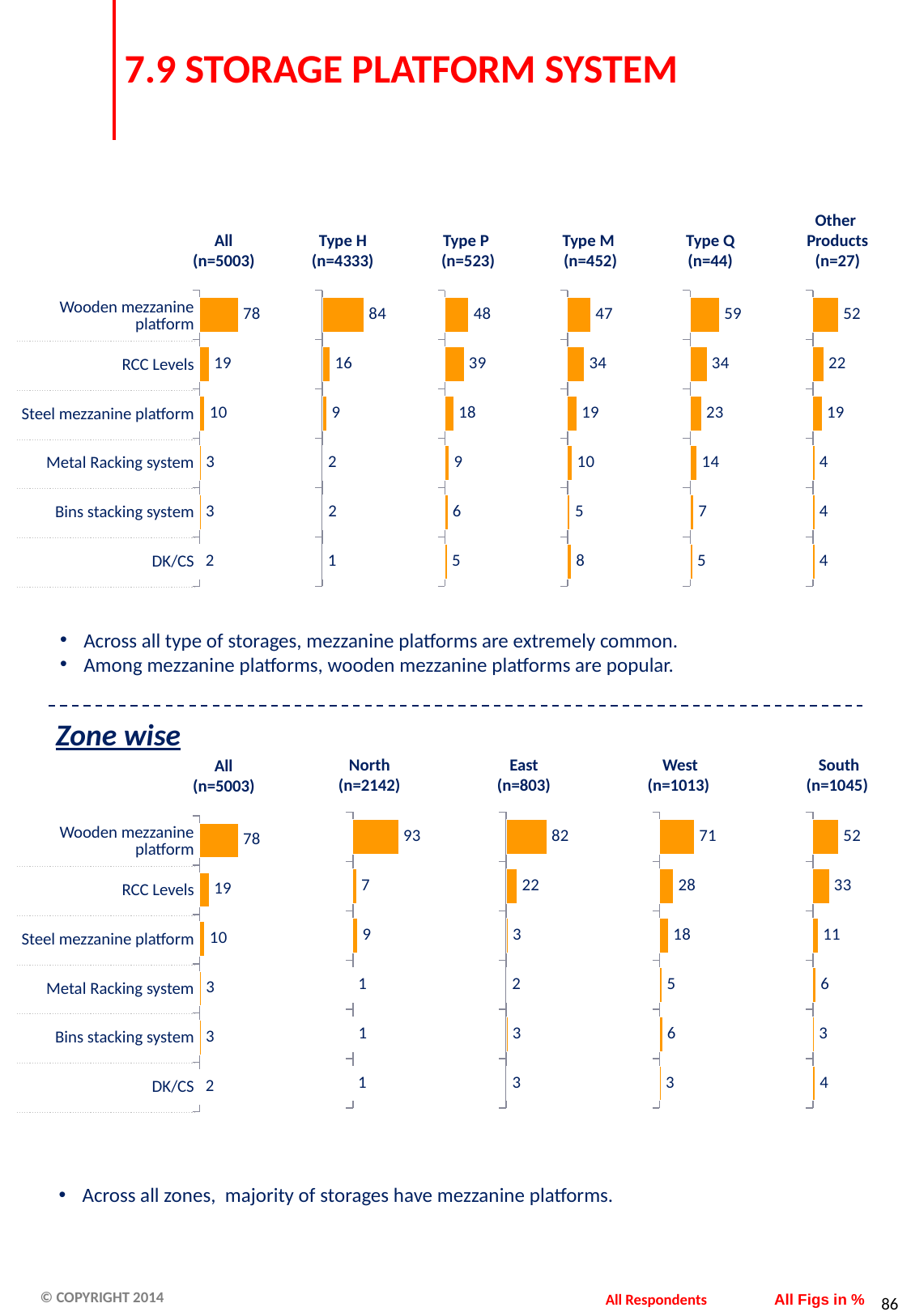
In the top section, is the value for Steel mezzanine platform larger in the Type Q (n=44) chart or the Type P (n=523) chart? Type Q (n=44) In the Zone wise section, what is the difference between Wooden mezzanine platform and RCC Levels in the West (n=1013) chart? 43 In the top section, what is the difference between Wooden mezzanine platform and RCC Levels in the Type M (n=452) chart? 13 What type of chart is used on this slide? Bar chart In the Zone wise section, which zone chart has the highest value for Wooden mezzanine platform? North (n=2142) In the Zone wise section, what is the value for RCC Levels in the South (n=1045) chart? 33 In the top section, which category has the highest value in the Type Q (n=44) chart? Wooden mezzanine platform In the top section (by storage type), what is the value for Wooden mezzanine platform in the Type H (n=4333) chart? 84 In the Zone wise section, what is the value for Wooden mezzanine platform in the North (n=2142) chart? 93 How many categories are listed in each chart of the Zone wise section? 6 In the top section, which category has the lowest value in the Type H (n=4333) chart? DK/CS In the top section, what is the value for RCC Levels in the Type P (n=523) chart? 39